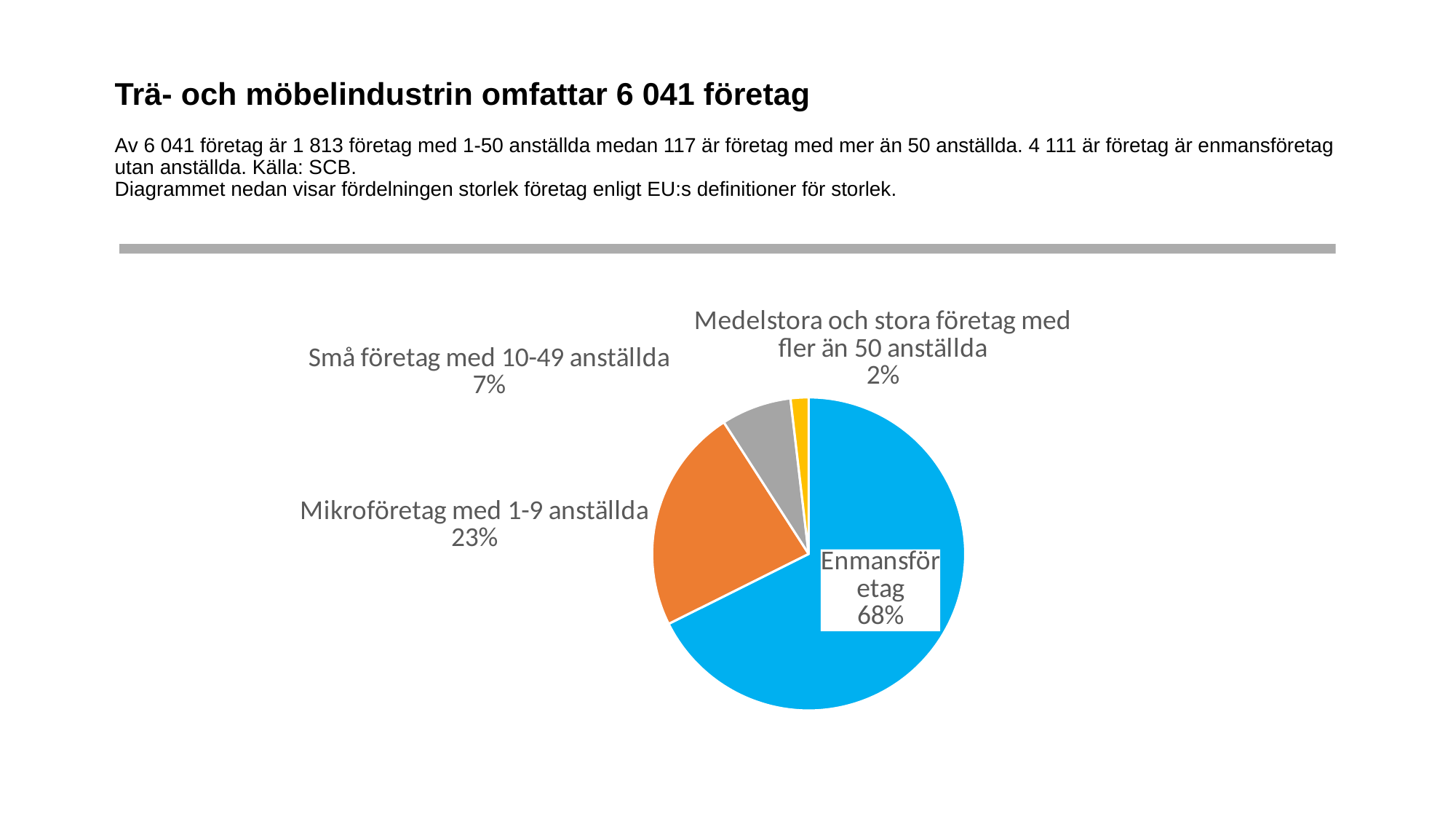
What kind of chart is shown on the slide? Pie chart What colour is the slice for Mikroföretag med 1-9 anställda? Orange What share of the pie does Medelstora och stora företag med fler än 50 anställda have? 2% How many slices does the pie chart have? 4 What colour is the slice for Enmansföretag? Blue What is the difference in percentage points between Enmansföretag and Mikroföretag med 1-9 anställda? 45 percentage points Which category has the largest slice of the pie? Enmansföretag What share of the pie does Enmansföretag have? 68% What share of the pie does Mikroföretag med 1-9 anställda have? 23% Which category has the smallest slice of the pie? Medelstora och stora företag med fler än 50 anställda Which is larger, the share for Små företag med 10-49 anställda or the share for Medelstora och stora företag med fler än 50 anställda? Små företag med 10-49 anställda